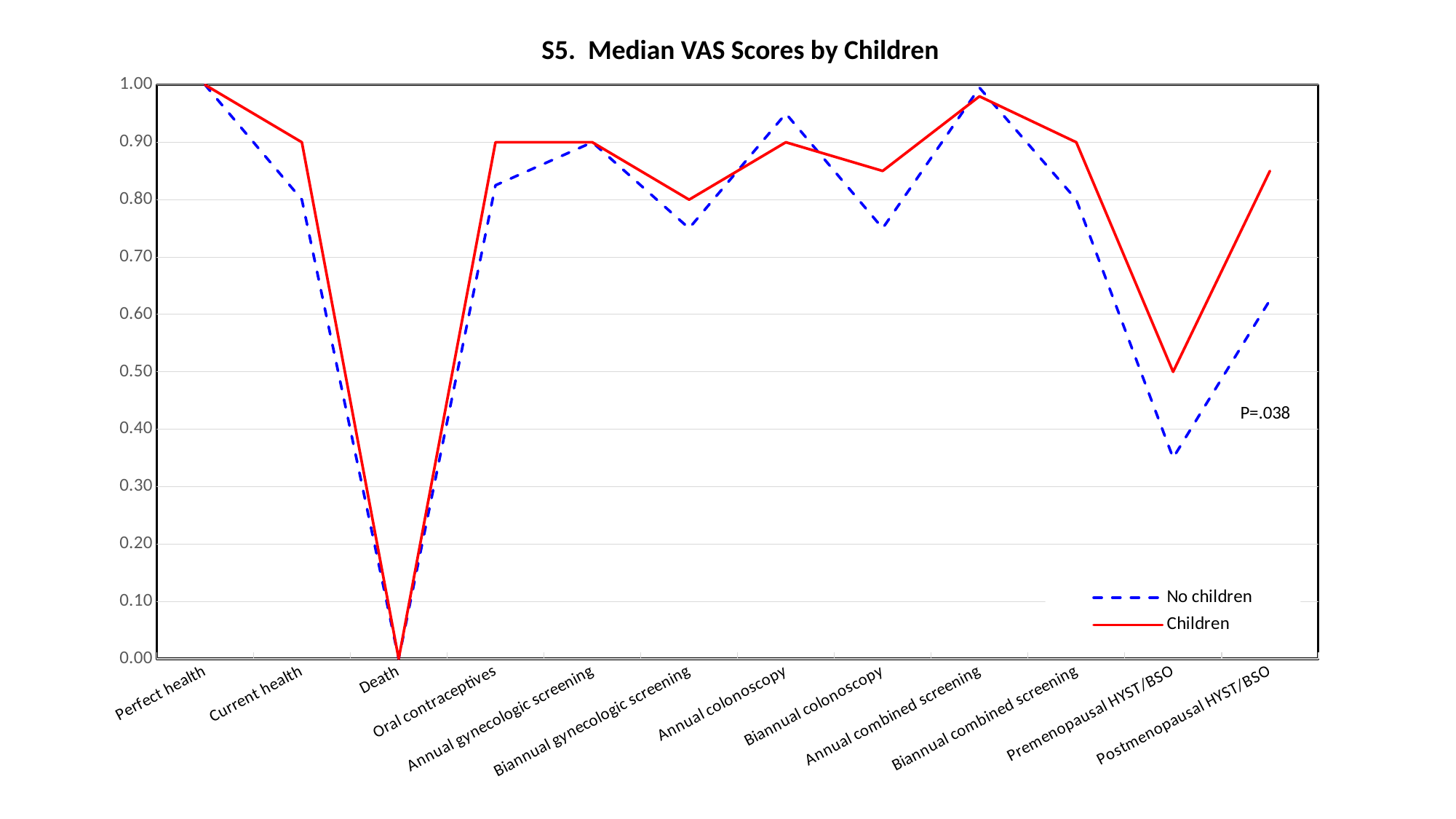
What is the median VAS score for the Children series at Death? 0.00 At Annual colonoscopy, which series has the higher value, Children or No children? No children At Premenopausal HYST/BSO, which series has the higher value, Children or No children? Children What is the median VAS score for the Children series at Biannual gynecologic screening? 0.80 Which category has the lowest value for the Children series? Death Is the value for No children at Premenopausal HYST/BSO greater or less than 0.40? less How many health-state categories are plotted along the x axis? 12 What kind of chart is shown on the slide? line chart What is the median VAS score for the Children series at Premenopausal HYST/BSO? 0.50 What P value is printed on the chart? P=.038 Is the value for No children at Postmenopausal HYST/BSO greater or less than 0.70? less How many series does the legend list? 2